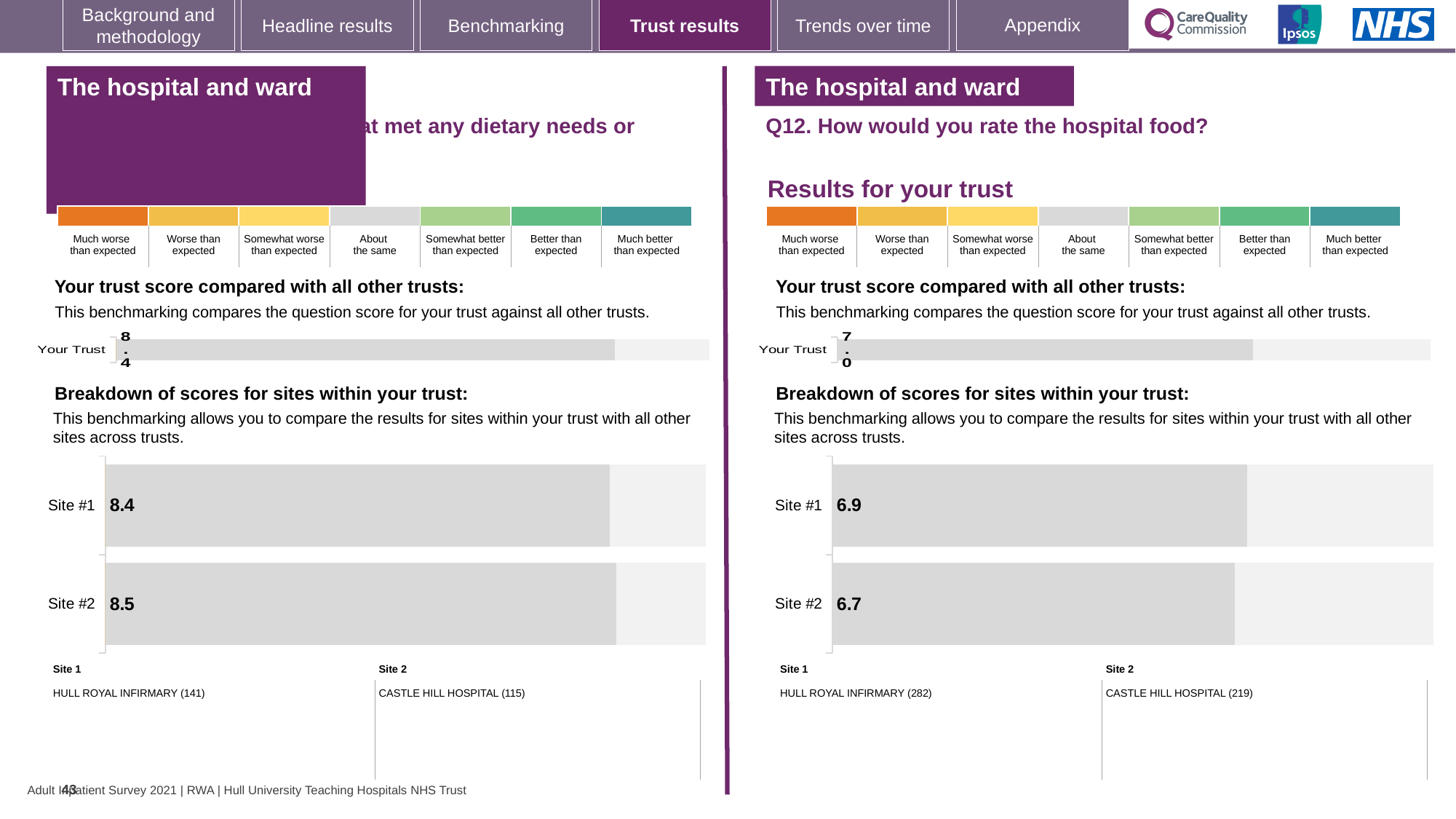
On the right-hand chart (Q12. How would you rate the hospital food?), what is the score for Site #1? 6.9 On the left-hand chart, what is the score for Site #2? 8.5 On the right-hand chart (Q12. How would you rate the hospital food?), what is the score for Site #2? 6.7 On the right-hand chart (Q12. How would you rate the hospital food?), which site has the higher score, Site #1 or Site #2? Site #1 On the left-hand chart, what is the score for Site #1? 8.4 On the right-hand chart (Q12. How would you rate the hospital food?), what is the difference between the Site #1 and Site #2 scores? 0.2 On the left-hand chart, what is the score for Your Trust? 8.4 On the left-hand chart, what is the difference between the Site #2 and Site #1 scores? 0.1 How many sites are shown in the site breakdown chart on the right-hand side of the slide? 2 On the right-hand side of the slide, which hospital is listed as Site 2? CASTLE HILL HOSPITAL (219) What type of chart is used to show the breakdown of scores for sites within the trust? Bar chart On the right-hand chart (Q12. How would you rate the hospital food?), what is the score for Your Trust? 7.0